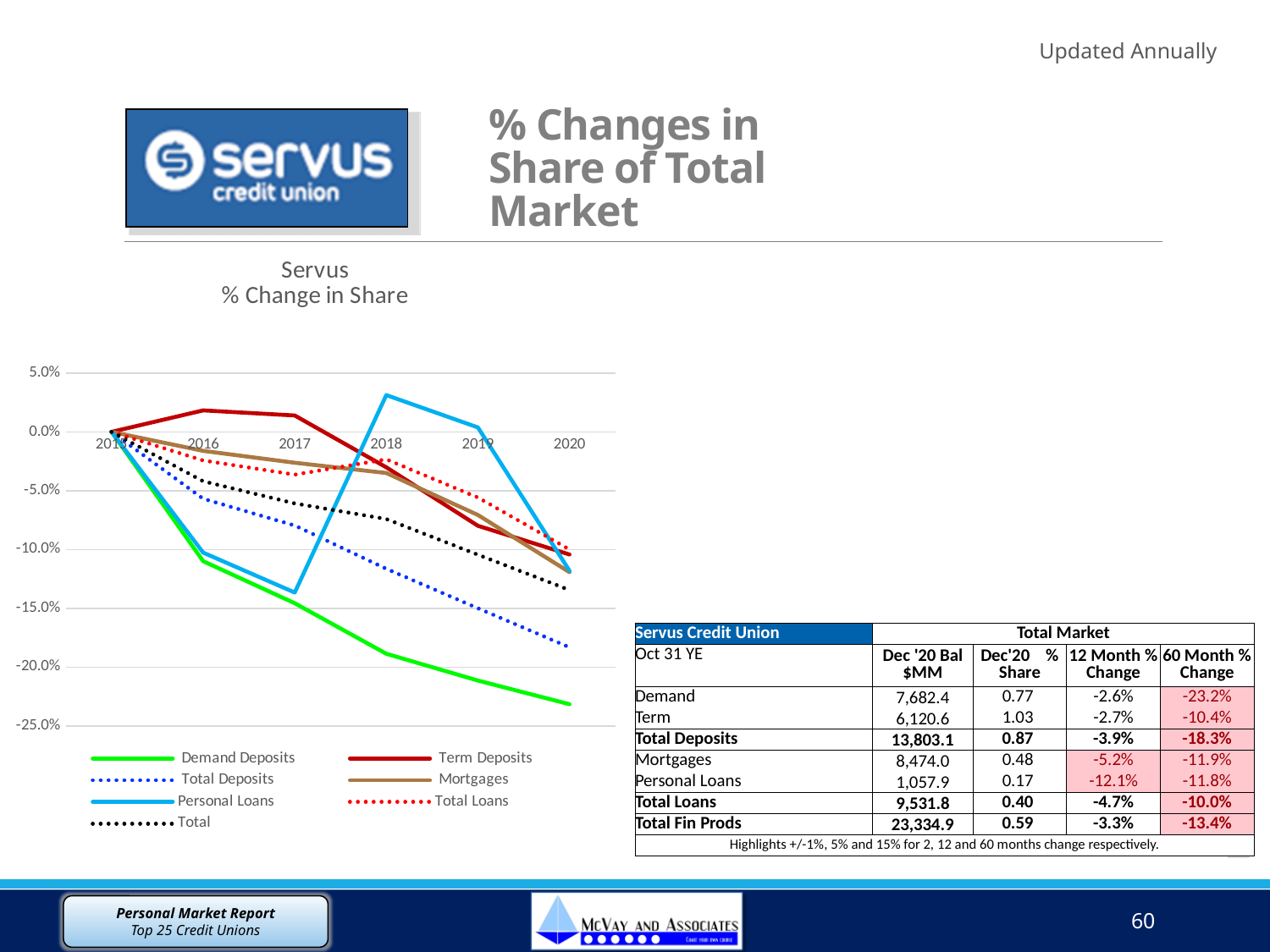
Is the value for Personal Loans in 2018 greater or less than 0.0%? greater Is the value for Personal Loans in 2017 greater or less than -10.0%? less Does the Demand Deposits line rise or fall from 2015 to 2020? fall What colour is the Demand Deposits line in the chart? green What kind of chart is shown on the slide? line chart Is the value for Demand Deposits in 2020 greater or less than -20.0%? less Which series has the highest value in 2016? Term Deposits How many series does the chart legend list? 7 Which series has the lowest value in 2020? Demand Deposits How many years are shown along the x axis of the chart? 6 In 2020, which is larger: the value for Demand Deposits or the value for Total Loans? Total Loans